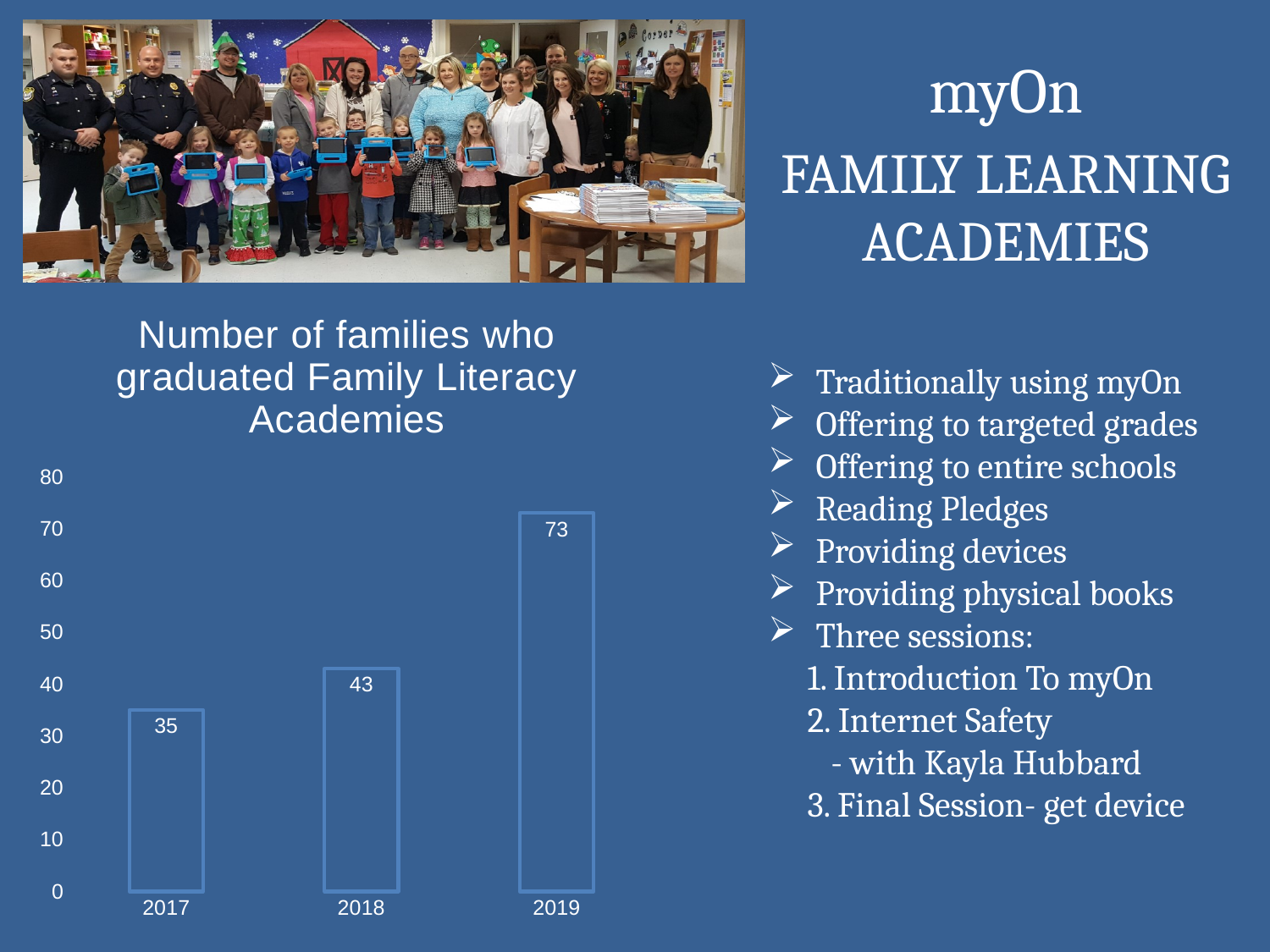
What is the difference between the values for 2019 and 2018? 30 Do the values rise or fall from 2017 to 2019? Rise Which is larger, the value for 2017 or the value for 2018? 2018 Which year has the lowest number of families who graduated? 2017 How many years are shown on the x axis of the chart? 3 How many families graduated Family Literacy Academies in 2017? 35 What is the value shown for 2019? 73 Is the value for 2019 greater or less than 60? greater What is the difference between the values for 2018 and 2017? 8 Which year has the highest number of families who graduated? 2019 What is the value shown for 2018? 43 What kind of chart is used to show the number of families who graduated? Bar chart